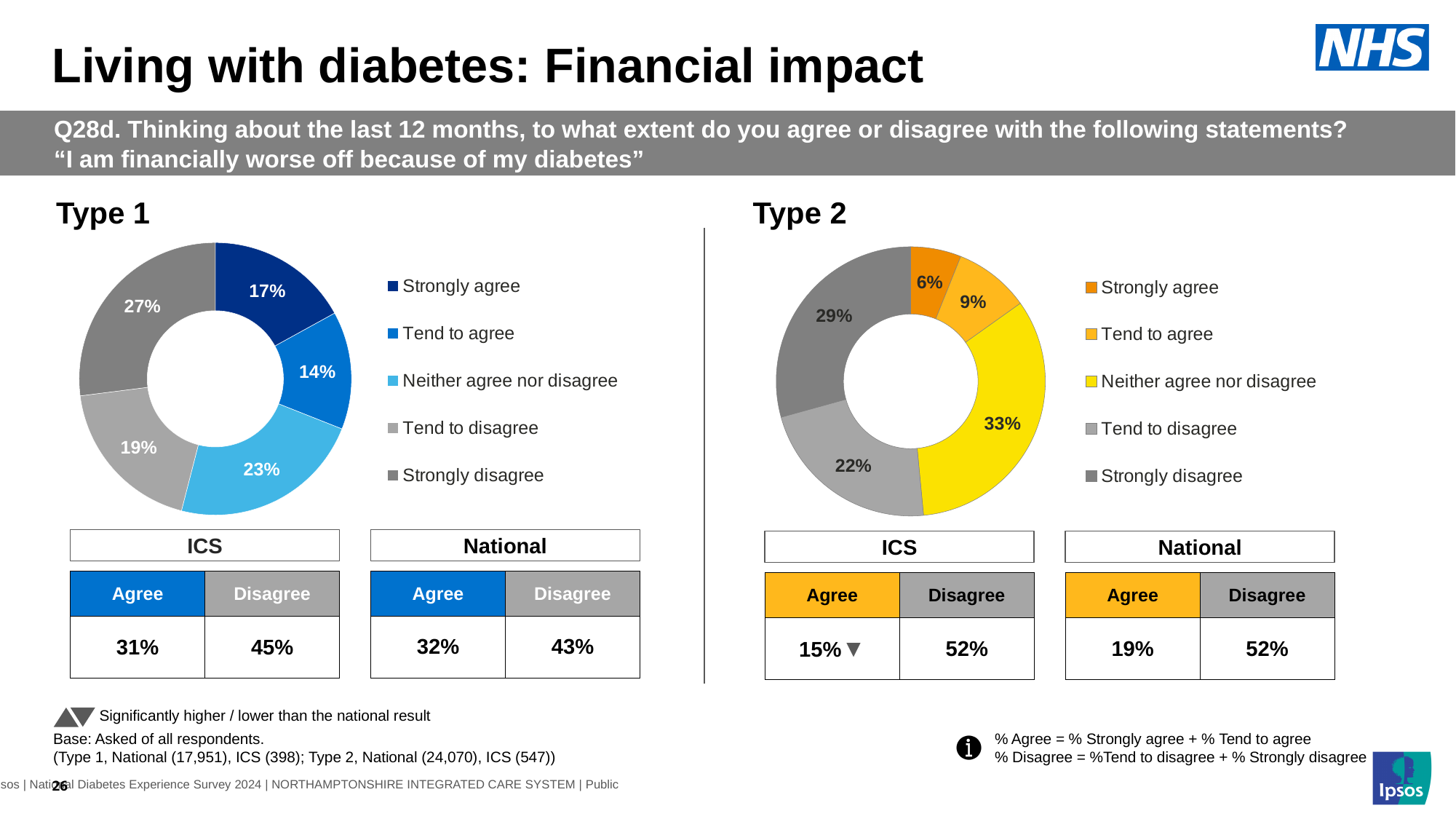
In the Type 2 chart, what is the difference between the 'Strongly disagree' and 'Strongly agree' percentages? 23 percentage points What kind of chart is used for the Type 1 data? Doughnut chart In the Type 2 chart, what percentage of respondents said 'Strongly disagree'? 29% In the Type 2 chart, what percentage of respondents said 'Neither agree nor disagree'? 33% How many response categories does the Type 2 chart show? 5 In the Type 2 chart, which response category has the smallest share? Strongly agree In the Type 1 chart, what percentage of respondents said 'Strongly agree'? 17% In the Type 2 chart, which is larger: 'Tend to agree' or 'Tend to disagree'? Tend to disagree In the Type 1 chart, what colour represents 'Neither agree nor disagree'? Light blue In the Type 1 chart, which response category has the largest share? Strongly disagree In the Type 1 chart, what is the difference between the 'Strongly disagree' and 'Tend to disagree' percentages? 8 percentage points In the Type 1 chart, what is the combined percentage of 'Strongly agree' and 'Tend to agree'? 31%